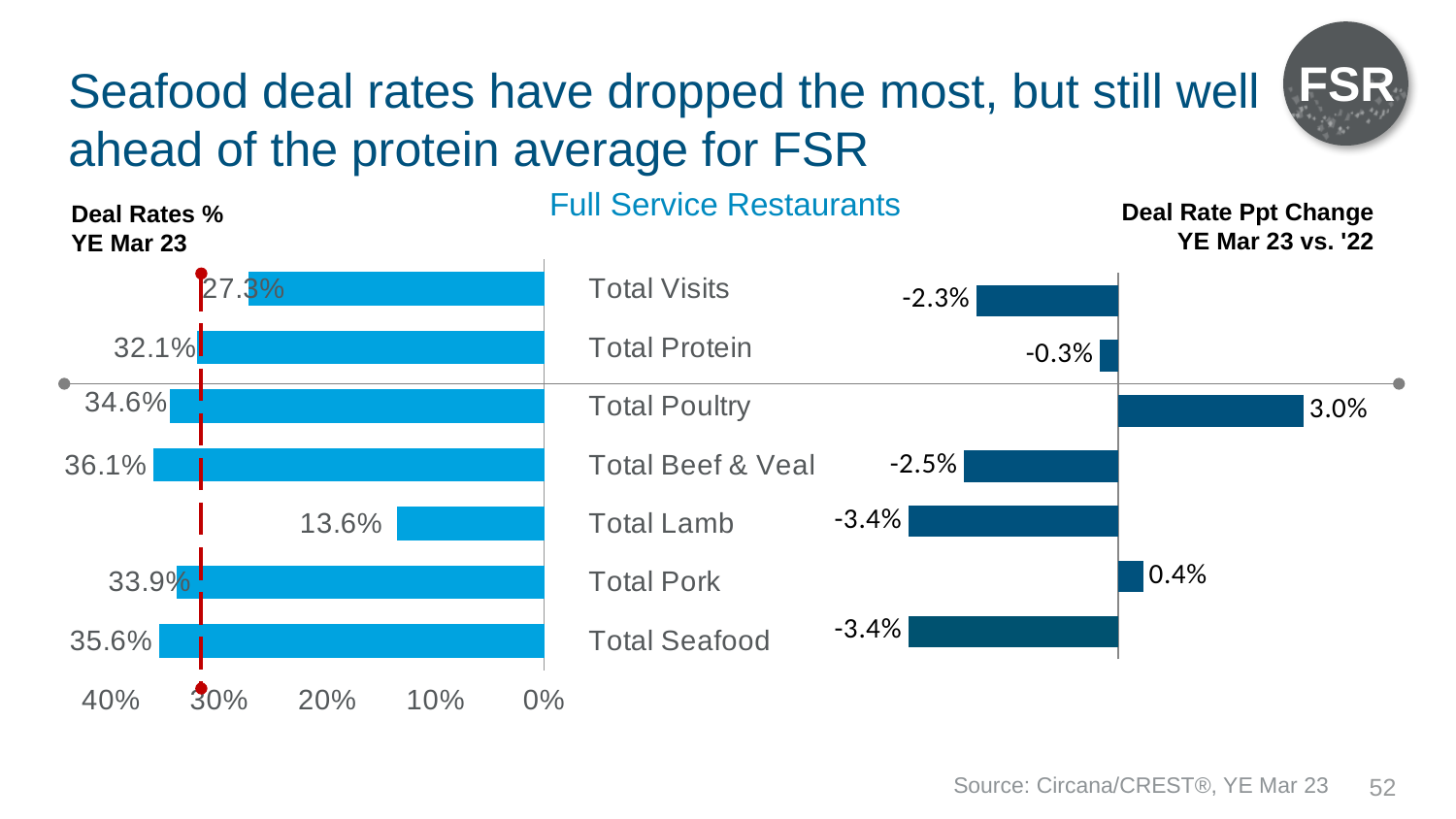
How many categories are shown in the Deal Rates % YE Mar 23 chart? 7 In the Deal Rates % YE Mar 23 chart, which category has the highest deal rate? Total Beef & Veal In the Deal Rate Ppt Change YE Mar 23 vs. '22 chart, which category has the largest positive change? Total Poultry In the Deal Rates % YE Mar 23 chart, what is the deal rate for Total Lamb? 13.6% In the Deal Rates % YE Mar 23 chart, what is the highest value shown on the axis? 40% In the Deal Rate Ppt Change YE Mar 23 vs. '22 chart, what is the change for Total Poultry? 3.0% In the Deal Rate Ppt Change YE Mar 23 vs. '22 chart, what is the change for Total Pork? 0.4% In the Deal Rates % YE Mar 23 chart, which is larger, the deal rate for Total Pork or for Total Visits? Total Pork In the Deal Rates % YE Mar 23 chart, which category has the lowest deal rate? Total Lamb What kind of chart is the Deal Rate Ppt Change YE Mar 23 vs. '22 chart? Bar chart In the Deal Rates % YE Mar 23 chart, what is the deal rate for Total Seafood? 35.6% In the Deal Rates % YE Mar 23 chart, how much higher is the deal rate for Total Seafood than for Total Protein? 3.5%